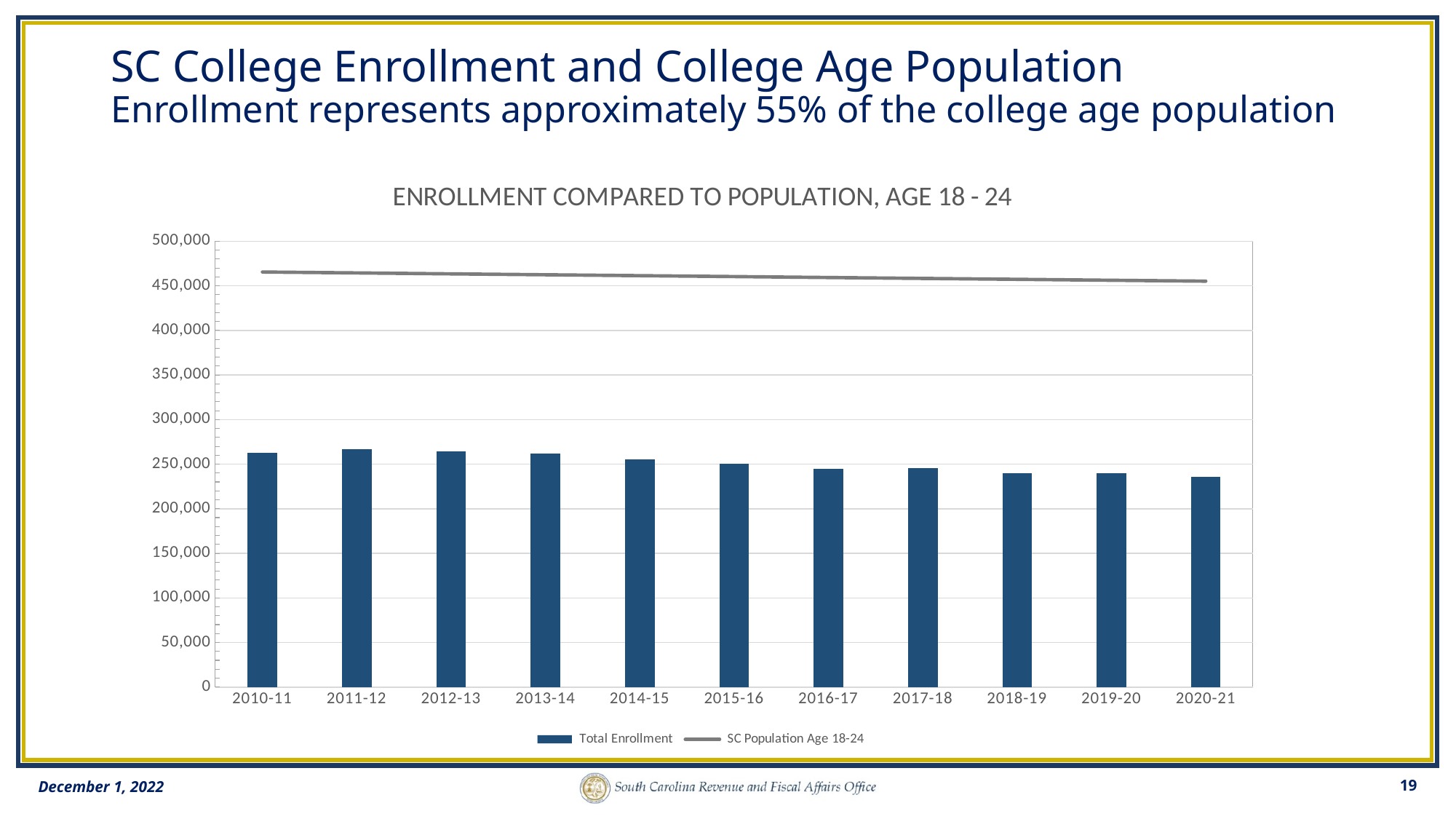
Is the SC Population Age 18-24 value for 2020-21 greater or less than 500,000? less What is the title of the chart? ENROLLMENT COMPARED TO POPULATION, AGE 18 - 24 What kind of chart is shown on the slide? A combined bar and line chart Does Total Enrollment generally rise or fall from 2010-11 to 2020-21? Fall How many series does the chart legend list? 2 What are the two series named in the chart legend? Total Enrollment and SC Population Age 18-24 Which academic year has the lowest Total Enrollment? 2020-21 How many academic years are shown on the x axis of the chart? 11 Which is larger, Total Enrollment in 2011-12 or in 2018-19? 2011-12 Is the SC Population Age 18-24 value for 2010-11 greater or less than 450,000? greater Is the Total Enrollment value for 2010-11 greater or less than 250,000? greater